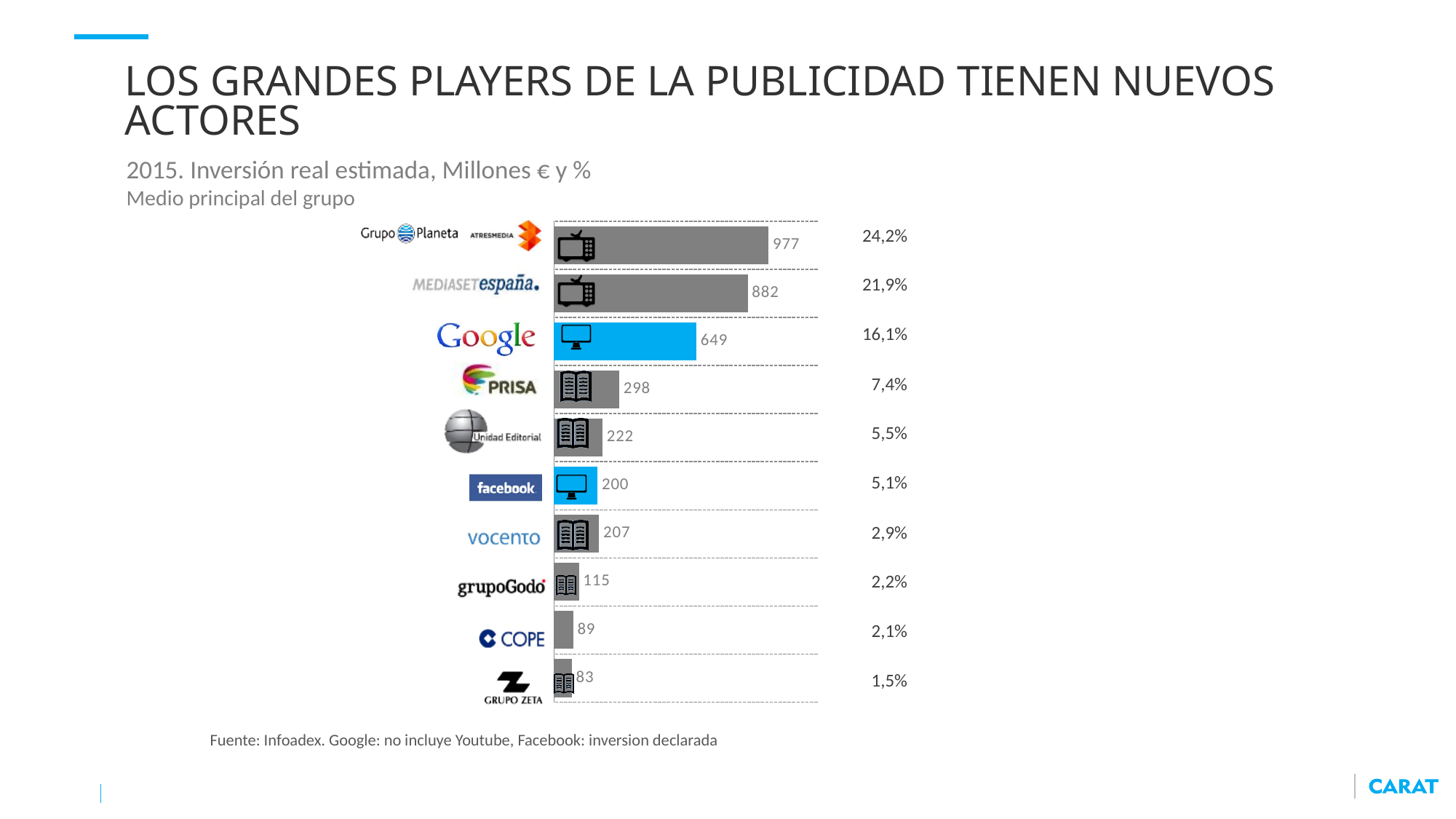
What percentage is shown next to the PRISA bar? 7,4% Which has a larger value, Vocento or Unidad Editorial? Unidad Editorial What is the value shown for Facebook? 200 What is the difference between the values for COPE and Grupo Zeta? 6 What is the difference between the values for Grupo Planeta/Atresmedia and Mediaset España? 95 Which group has the highest investment value in the chart? Grupo Planeta / Atresmedia How many groups are shown in the chart? 10 What is the value shown for Mediaset España? 882 Which bars are coloured blue instead of grey in the chart? Google and Facebook Which group has the lowest investment value in the chart? Grupo Zeta What is the estimated real investment value shown for Google? 649 What type of chart is shown on the slide? Bar chart